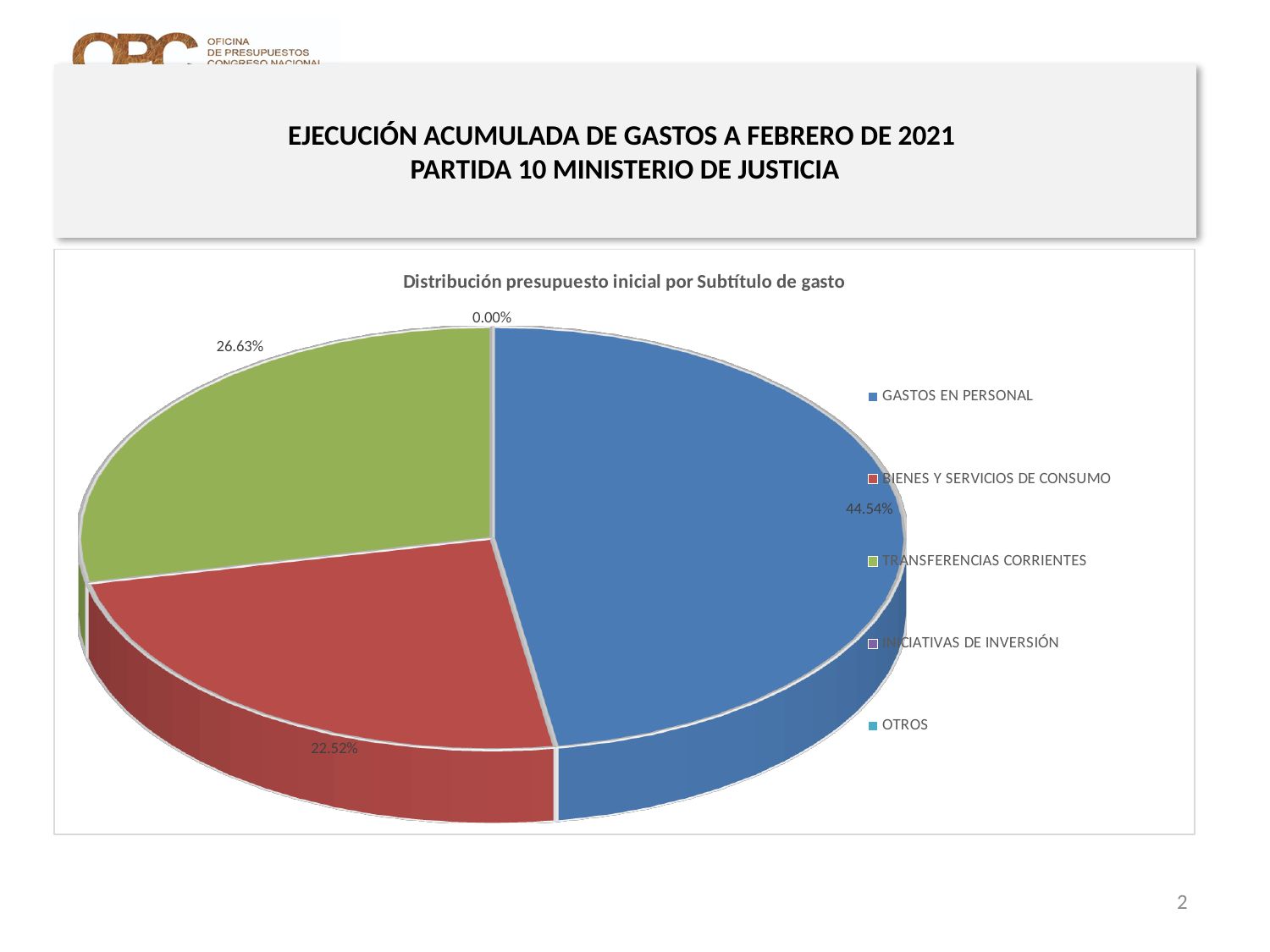
What percentage is shown for BIENES Y SERVICIOS DE CONSUMO? 22.52% Which is larger, the slice for GASTOS EN PERSONAL or the slice for BIENES Y SERVICIOS DE CONSUMO? GASTOS EN PERSONAL What percentage is shown for TRANSFERENCIAS CORRIENTES? 26.63% What type of chart is shown on the slide? pie chart What is the difference in percentage points between GASTOS EN PERSONAL and TRANSFERENCIAS CORRIENTES? 17.91 How many categories does the legend list? 5 What is the chart's title? Distribución presupuesto inicial por Subtítulo de gasto Which category has the largest slice of the pie? GASTOS EN PERSONAL What colour is the slice for GASTOS EN PERSONAL? blue What percentage is shown for GASTOS EN PERSONAL? 44.54% What is the difference in percentage points between TRANSFERENCIAS CORRIENTES and BIENES Y SERVICIOS DE CONSUMO? 4.11 Which is larger, the slice for TRANSFERENCIAS CORRIENTES or the slice for BIENES Y SERVICIOS DE CONSUMO? TRANSFERENCIAS CORRIENTES